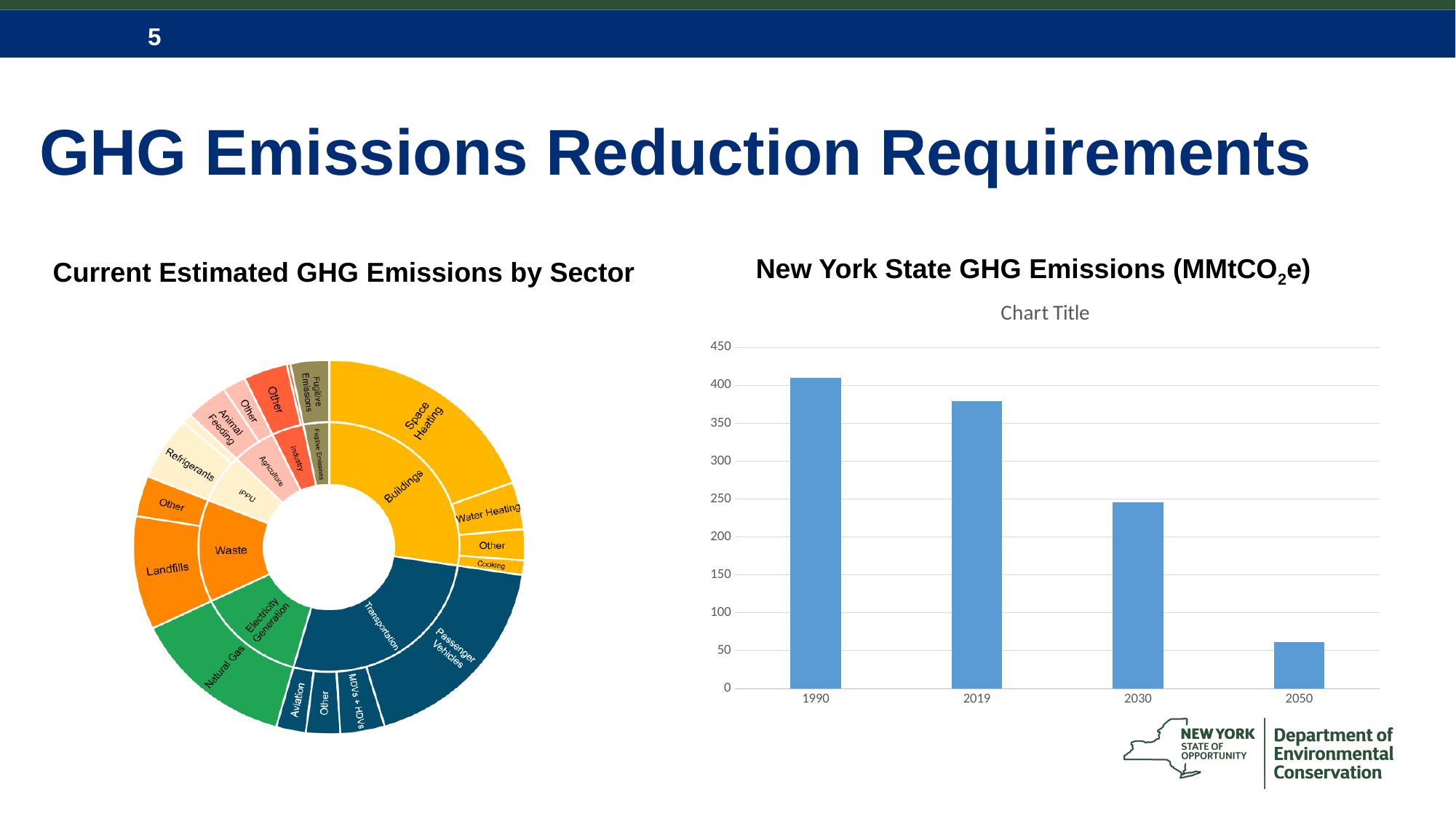
In the 'New York State GHG Emissions (MMtCO2e)' bar chart, is the value for 1990 greater or less than 400? greater In the 'New York State GHG Emissions (MMtCO2e)' bar chart, how many years are shown on the x axis? 4 In the 'New York State GHG Emissions (MMtCO2e)' bar chart, which year has the highest bar? 1990 In the 'New York State GHG Emissions (MMtCO2e)' bar chart, which is larger, the value for 2019 or the value for 2030? 2019 In the 'Current Estimated GHG Emissions by Sector' chart on the left, which sub-category in the outer ring has the largest segment? Space Heating In the 'New York State GHG Emissions (MMtCO2e)' bar chart, do the values rise or fall from 1990 to 2050? fall What kind of chart is the chart on the right of the slide, under 'New York State GHG Emissions (MMtCO2e)'? bar chart In the 'New York State GHG Emissions (MMtCO2e)' bar chart, what placeholder title is printed above the plot area? Chart Title In the 'New York State GHG Emissions (MMtCO2e)' bar chart, is the value for 2030 greater or less than 300? less In the 'New York State GHG Emissions (MMtCO2e)' bar chart, is the value for 2050 greater or less than 100? less In the 'Current Estimated GHG Emissions by Sector' chart on the left, which sector in the inner ring has the smallest segment? Fugitive Emissions In the 'New York State GHG Emissions (MMtCO2e)' bar chart, which year has the lowest bar? 2050